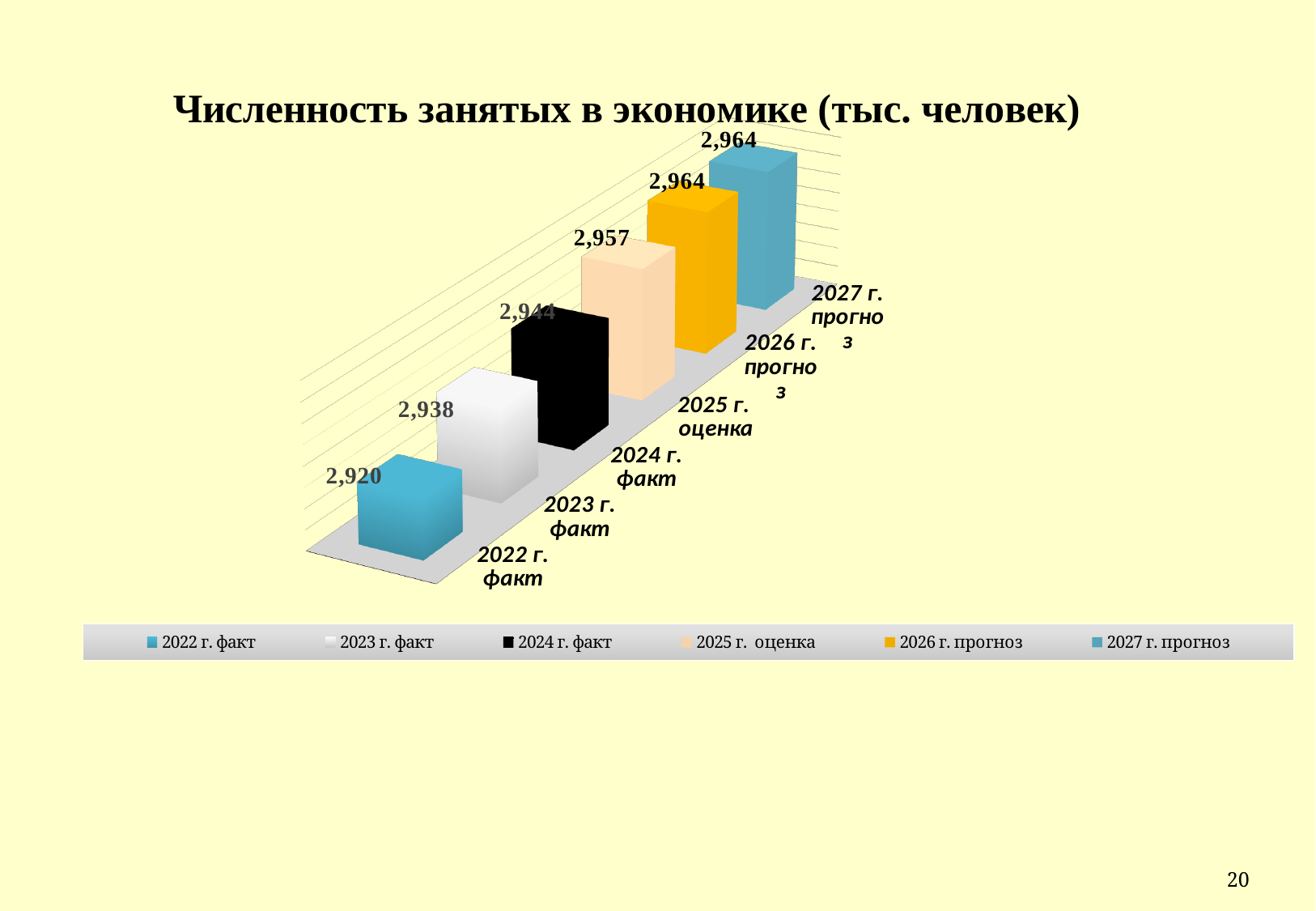
Which category has the lowest value? 2022 г. факт What is the value for 2027 г. прогноз? 2,964 What kind of chart is shown on the slide? bar chart How many entries does the legend list? 6 Which is larger, the value for 2024 г. факт or the value for 2023 г. факт? 2024 г. факт What is the value for 2022 г. факт? 2,920 What is the value for 2024 г. факт? 2,944 What is the difference between the values for 2026 г. прогноз and 2022 г. факт? 44 Do the values rise or fall from 2022 г. факт to 2027 г. прогноз? rise How many categories are shown in the chart? 6 What is the value for 2025 г. оценка? 2,957 What is the difference between the values for 2025 г. оценка and 2023 г. факт? 19